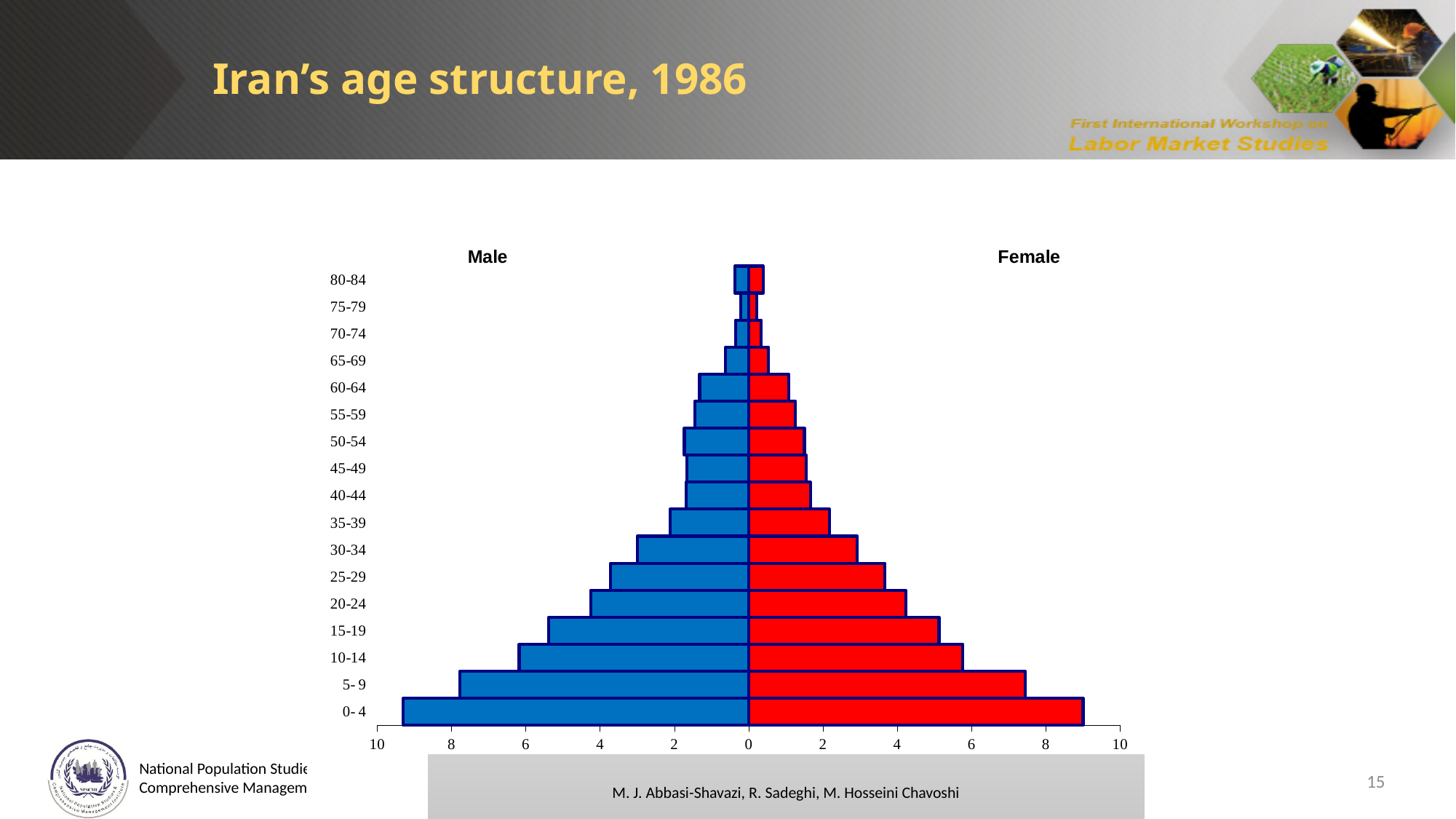
Which is larger, the Male value for 0- 4 or the Male value for 5- 9? 0- 4 Is the Female value for the 30-34 age group greater or less than 4? less Which colour represents the Female series? red Which age group has the largest Male value? 0- 4 How many series does the chart show? 2 How many age groups are shown on the chart? 17 Which age group has the smallest Male value? 75-79 Which age group has the largest Female value? 0- 4 What is the title of the chart on the slide? Iran's age structure, 1986 Is the Male value for the 0- 4 age group greater or less than 8? greater What kind of chart is shown on the slide? bar chart Do the bar lengths generally increase or decrease as the age groups get older? decrease